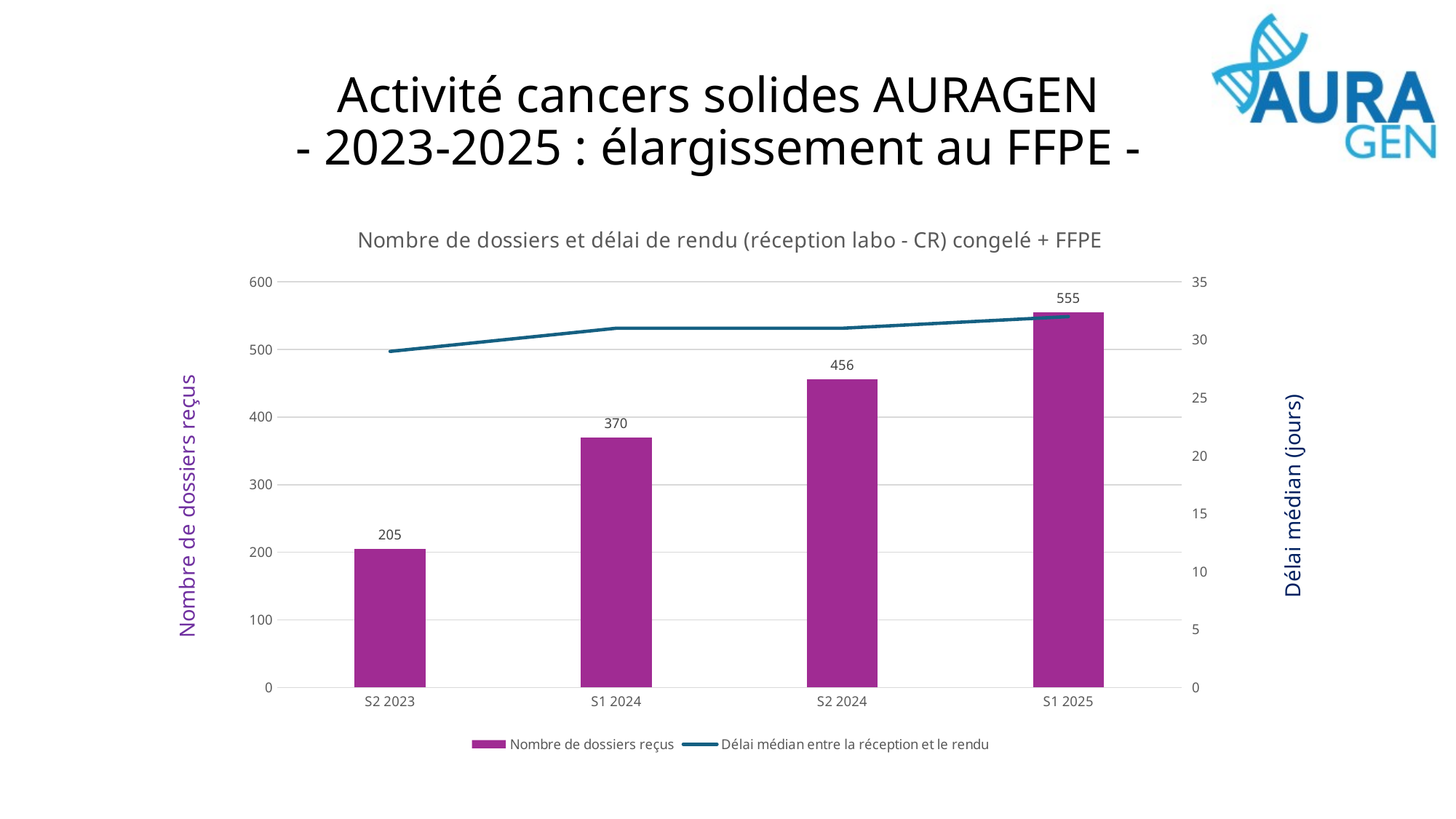
What is the number of dossiers reçus for S1 2024? 370 What is the difference in dossiers reçus between S1 2025 and S2 2024? 99 What is the number of dossiers reçus for S1 2025? 555 Which period has more dossiers reçus, S1 2024 or S2 2024? S2 2024 Is the délai médian for S2 2023 greater or less than 25 days? greater How many series does the legend list? 2 Which period has the highest number of dossiers reçus? S1 2025 How many periods are shown on the x axis? 4 Which period has the lowest number of dossiers reçus? S2 2023 Do the number of dossiers reçus rise or fall from S2 2023 to S1 2025? rise What is the number of dossiers reçus for S2 2023? 205 Is the délai médian for S1 2025 greater or less than 30 days? greater